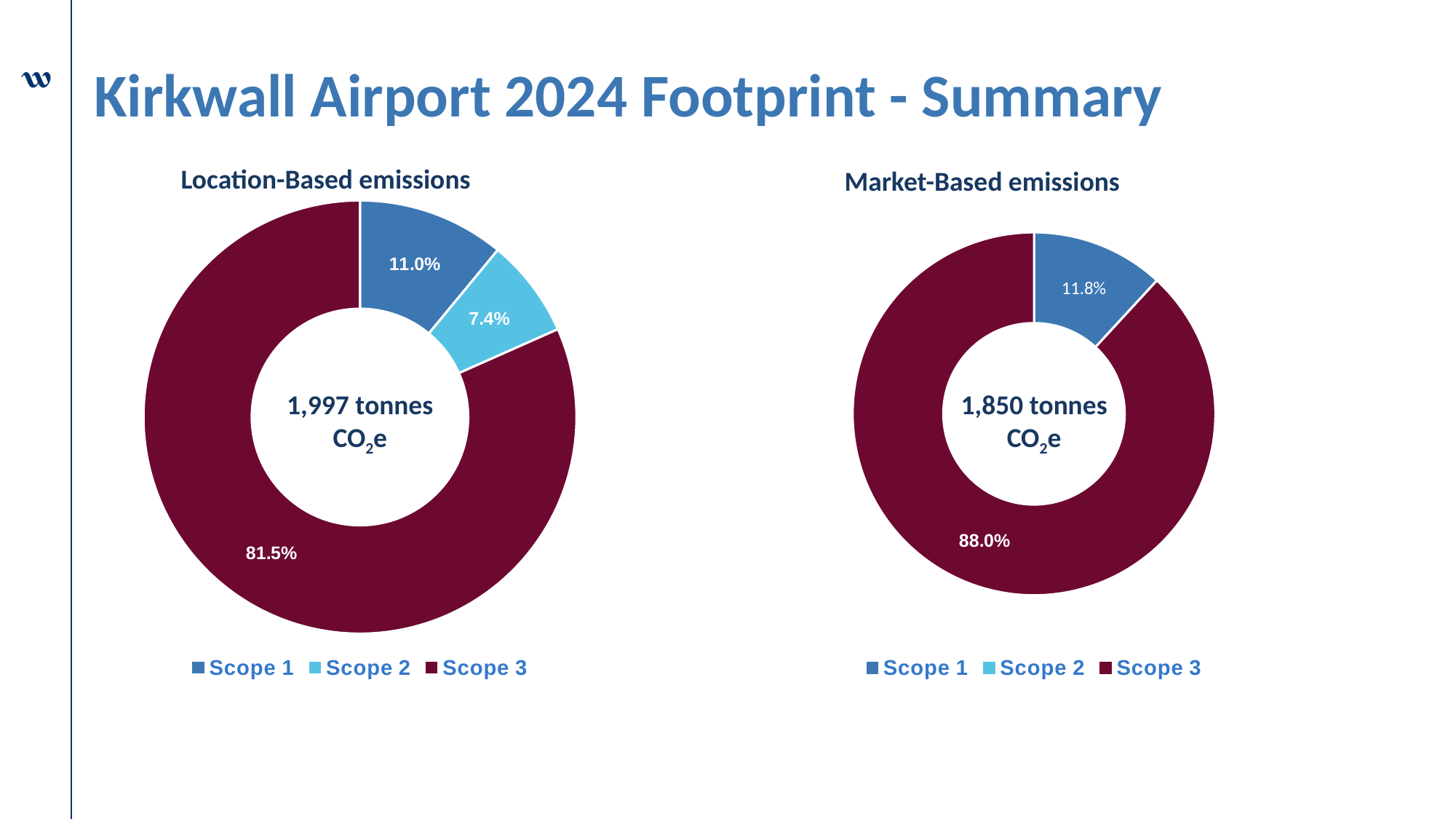
Which is larger in the Location-Based emissions chart, the Scope 1 share or the Scope 2 share? Scope 1 What kind of chart is the Market-Based emissions chart? Doughnut chart In the Location-Based emissions chart, what share of emissions is Scope 2? 7.4% In the Market-Based emissions chart, what share of emissions is Scope 1? 11.8% How many series does the legend of the Location-Based emissions chart list? 3 In the Market-Based emissions chart, what share of emissions is Scope 3? 88.0% What total is shown in the centre of the Market-Based emissions chart? 1,850 tonnes CO2e In the Location-Based emissions chart, what share of emissions is Scope 3? 81.5% In the Location-Based emissions chart, which scope has the smallest share? Scope 2 In the Location-Based emissions chart, what is the difference between the Scope 1 and Scope 2 shares? 3.6% What total is shown in the centre of the Location-Based emissions chart? 1,997 tonnes CO2e In the Location-Based emissions chart, which scope has the largest share? Scope 3